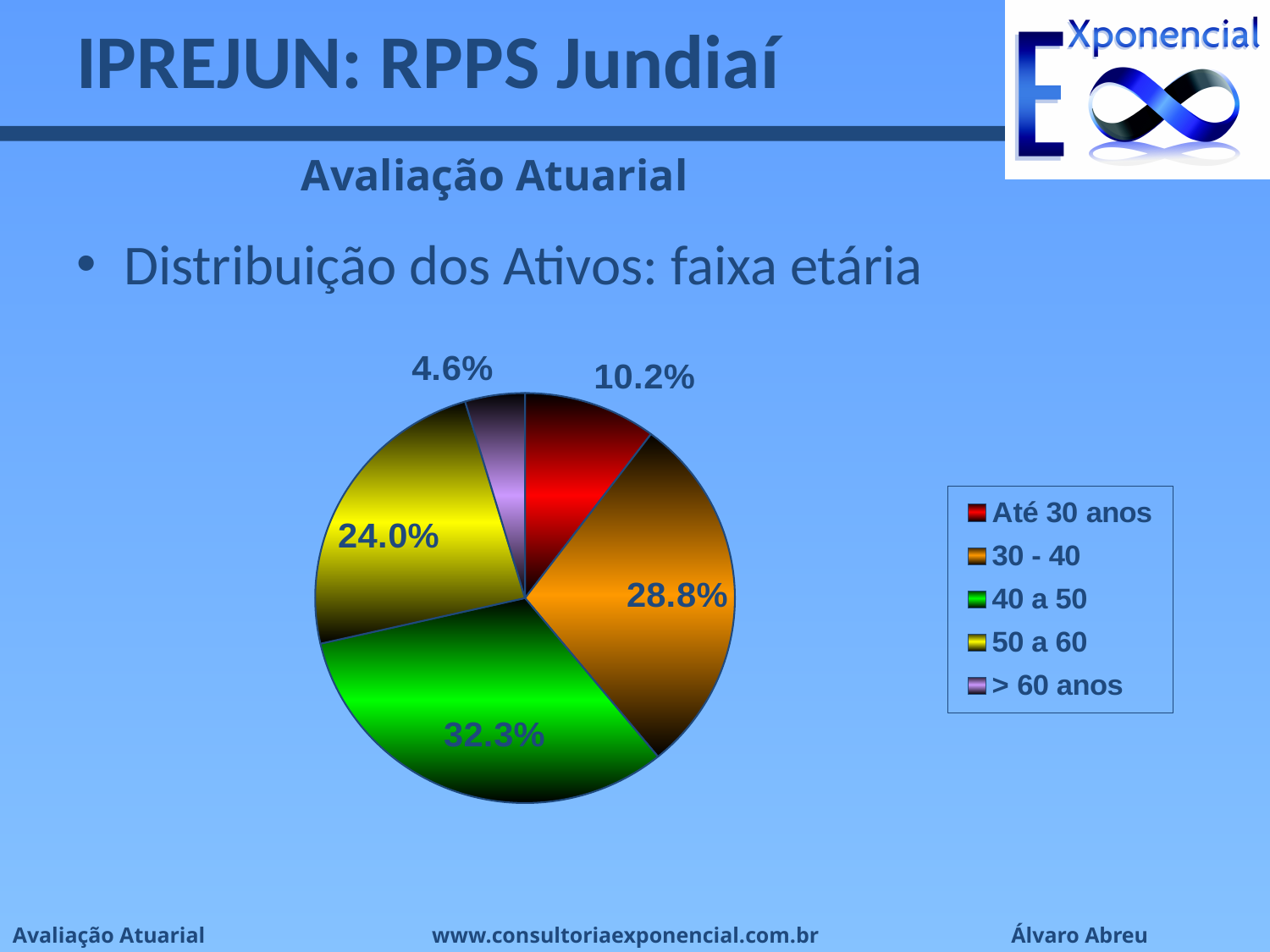
What share of the pie does the '40 a 50' age group represent? 32.3% Which age group has the largest share of the pie? 40 a 50 What share of the pie does the 'Até 30 anos' age group represent? 10.2% What is the difference between the shares of the '40 a 50' and '30 - 40' age groups? 3.5% Which is larger, the share for '50 a 60' or the share for 'Até 30 anos'? 50 a 60 Which age group has the smallest share of the pie? > 60 anos How many age groups are shown in the pie chart? 5 What share of the pie does the '> 60 anos' age group represent? 4.6% What is the value shown for the '50 a 60' age group? 24.0% What type of chart is shown on the slide? pie chart Which colour represents the '50 a 60' age group in the legend? yellow What is the value shown for the '30 - 40' age group? 28.8%